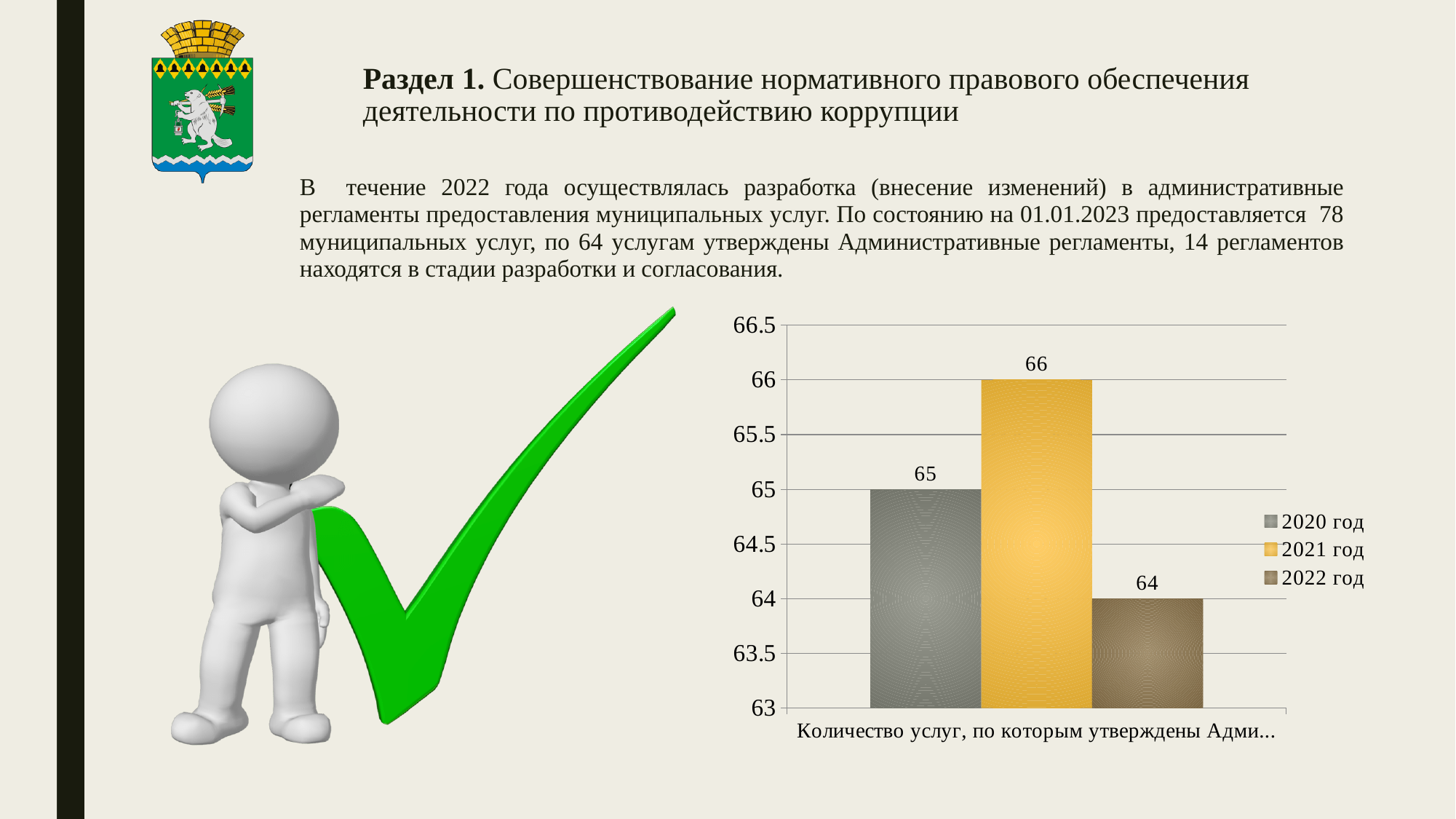
What colour is the bar for 2021 год? yellow What kind of chart is shown on the slide? bar chart What is the difference between the values for 2021 год and 2022 год? 2 Which is larger, the value for 2020 год or the value for 2022 год? 2020 год What is the difference between the values for 2020 год and 2022 год? 1 What is the value for 2021 год in the chart? 66 Is the value for 2021 год greater or less than 65.5? greater What is the value for 2022 год in the chart? 64 Which series has the highest value in the chart? 2021 год How many series does the legend list? 3 What is the value for 2020 год in the chart? 65 Which series has the lowest value in the chart? 2022 год